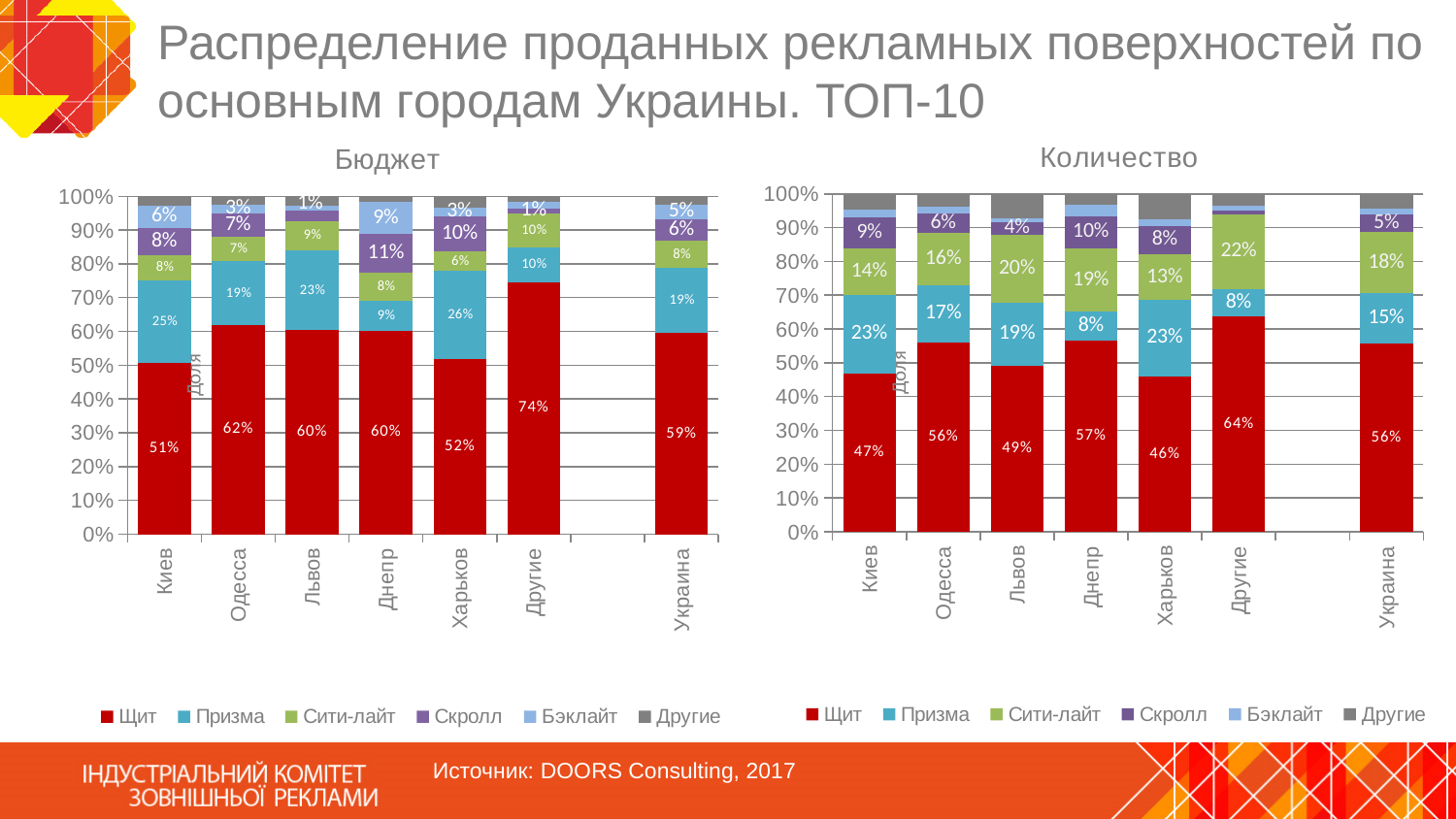
On the Бюджет chart, what is the Призма share for Киев? 25% What type of chart is the Бюджет chart? Stacked bar chart On the Количество chart, what is the Щит share for Харьков? 46% On the Бюджет chart, what is the Щит share for Другие? 74% On the Бюджет chart, which city has the highest Щит share? Другие How many categories are shown on the x axis of the Количество chart? 7 On the Количество chart, which is larger: the Призма share for Киев or for Днепр? Киев On the Количество chart, which category has the lowest Щит share? Харьков On the Количество chart, what is the Сити-лайт share for Львов? 20% How many series does the legend of the Бюджет chart list? 6 What is the title of the chart on the right side of the slide? Количество On the Бюджет chart, what is the difference between the Щит share for Одесса and for Киев? 11%